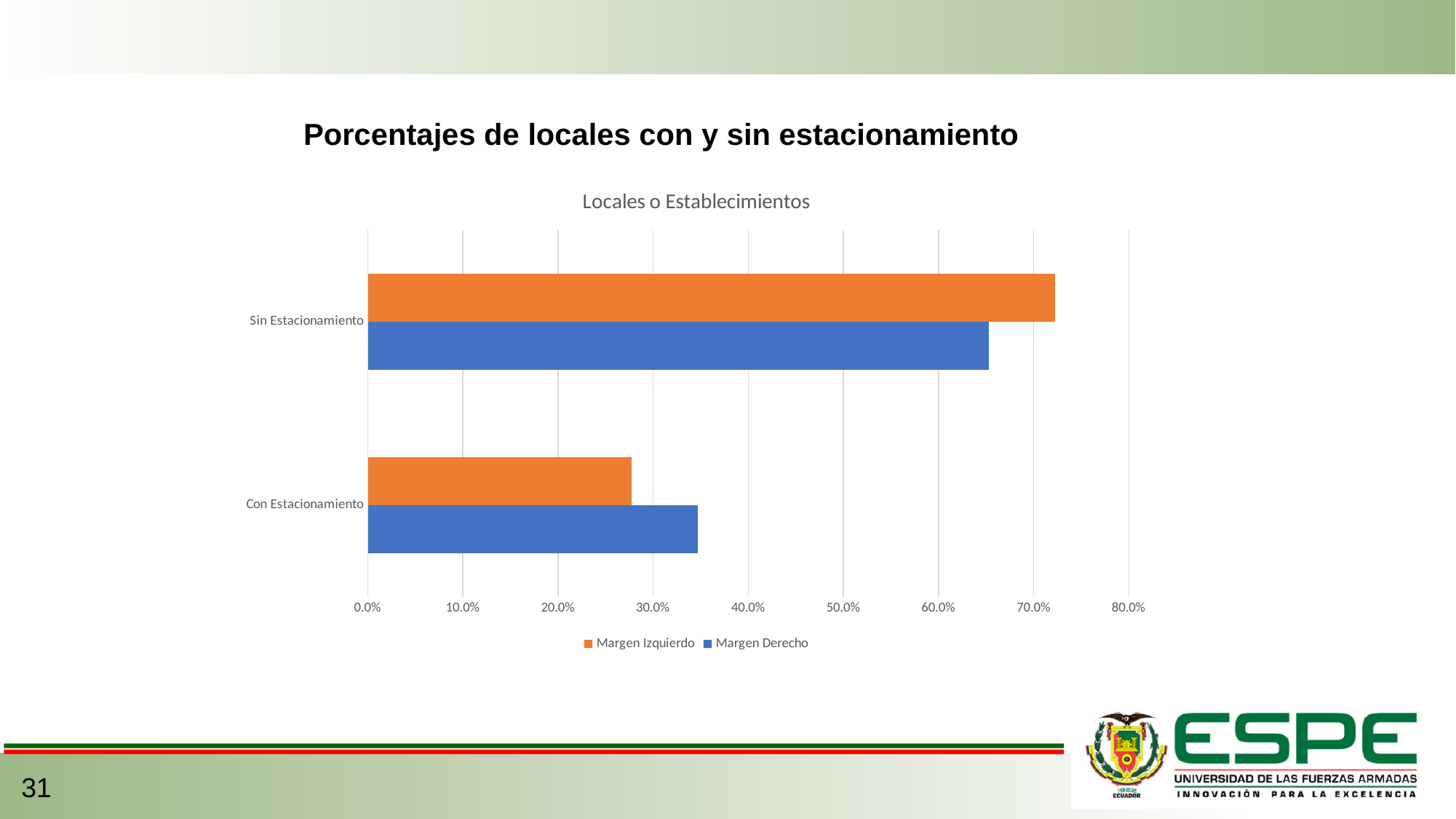
Is the Margen Izquierdo value for Sin Estacionamiento greater or less than 60.0%? greater For Con Estacionamiento, which series has the larger value, Margen Izquierdo or Margen Derecho? Margen Derecho What is the title shown inside the chart area? Locales o Establecimientos For the Margen Izquierdo series, which category has the highest value? Sin Estacionamiento Is the Margen Derecho value for Sin Estacionamiento greater or less than 70.0%? less For Sin Estacionamiento, which series has the larger value, Margen Izquierdo or Margen Derecho? Margen Izquierdo Is the Margen Izquierdo value for Con Estacionamiento greater or less than 30.0%? less How many series does the chart legend list? 2 Which colour represents the Margen Derecho series? blue For the Margen Derecho series, which category has the lowest value? Con Estacionamiento How many categories are shown on the vertical axis of the chart? 2 What kind of chart is shown on the slide? bar chart